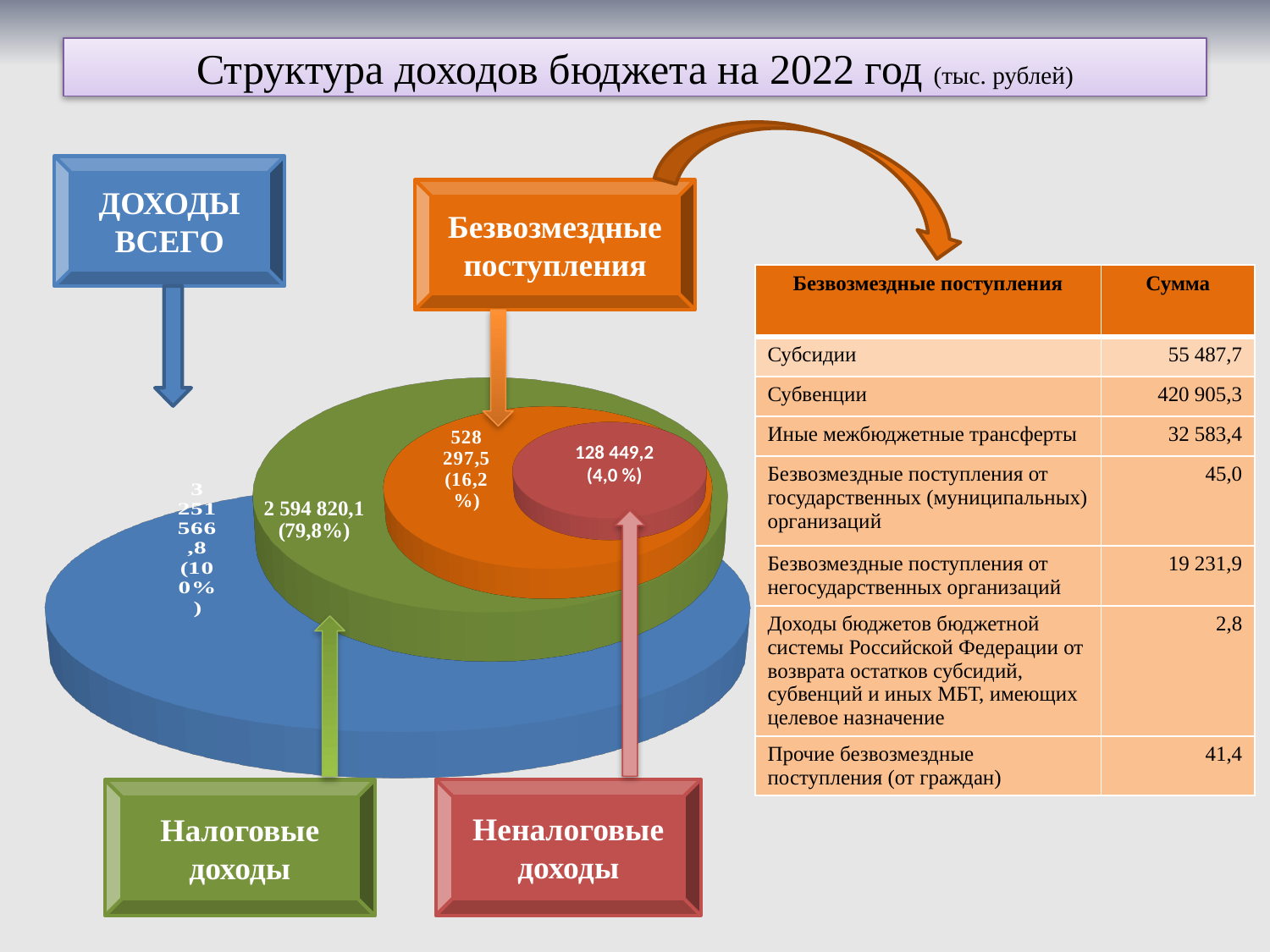
What is the total value shown for Доходы всего? 3 251 566,8 What is the difference between the values for Безвозмездные поступления and Неналоговые доходы? 399 848,3 What percentage share is shown for Безвозмездные поступления? 16,2 % What percentage share is shown for Налоговые доходы? 79,8% Which income component has the largest share: Налоговые доходы, Безвозмездные поступления or Неналоговые доходы? Налоговые доходы Which is larger, the value for Безвозмездные поступления or the value for Неналоговые доходы? Безвозмездные поступления What is the value shown for Налоговые доходы on the chart? 2 594 820,1 What percentage share is shown for Неналоговые доходы? 4,0 % What is the value shown for Безвозмездные поступления on the chart? 528 297,5 What is the title of the slide's chart? Структура доходов бюджета на 2022 год (тыс. рублей) What is the value shown for Неналоговые доходы on the chart? 128 449,2 Which income component has the smallest share: Налоговые доходы, Безвозмездные поступления or Неналоговые доходы? Неналоговые доходы